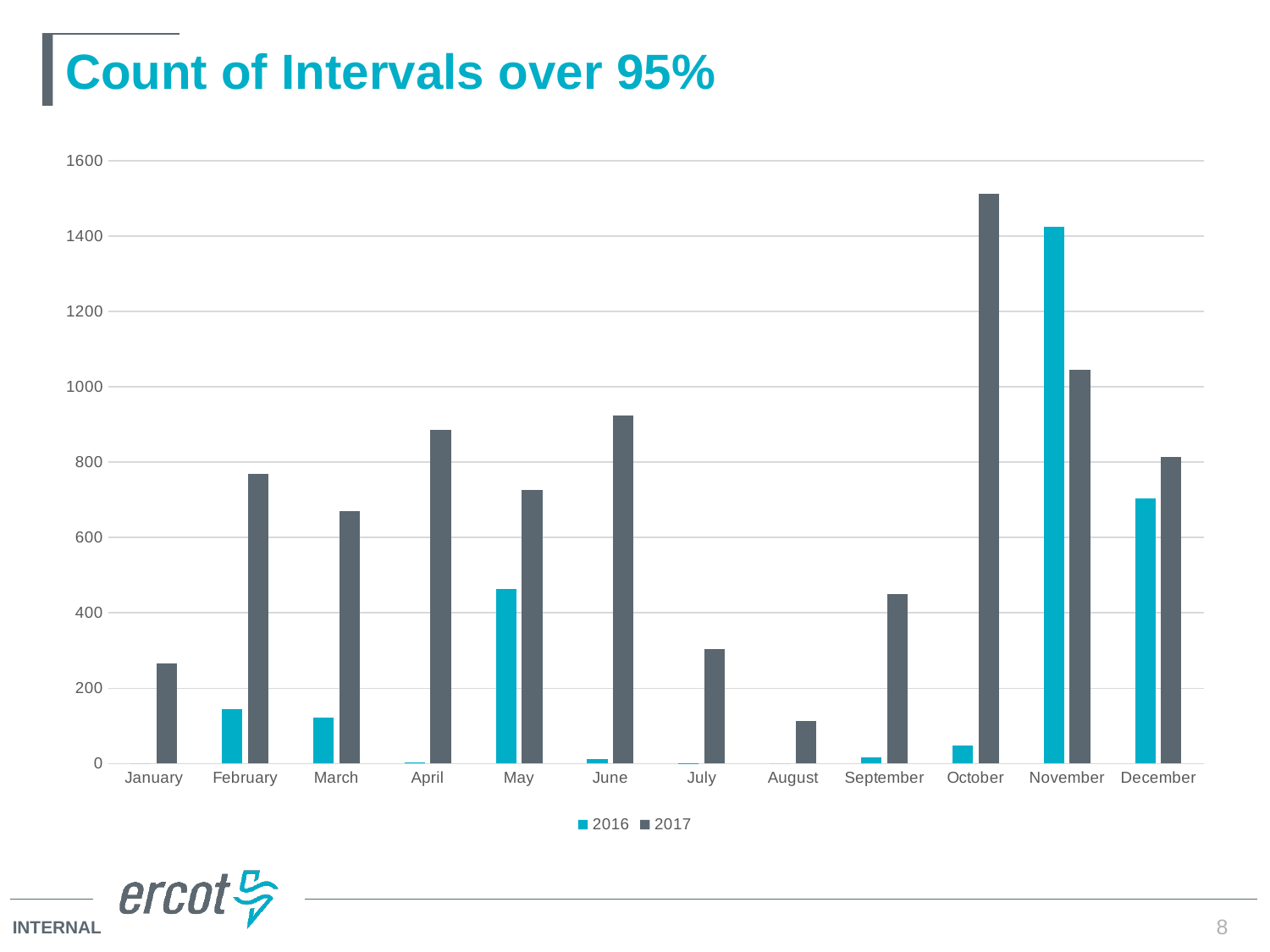
How many months are shown on the x axis? 12 Is the 2016 value for May greater or less than 400? greater Which month has the highest value for 2016? November Which month has the highest value for 2017? October Is the 2017 value for June greater or less than 800? greater Is the 2016 value for December greater or less than 800? less In November, which series has the larger value, 2016 or 2017? 2016 What is the title of the chart? Count of Intervals over 95% In October, which series has the larger value, 2016 or 2017? 2017 Which month has the lowest value for 2017? August How many series does the legend list? 2 What kind of chart is shown on the slide? bar chart